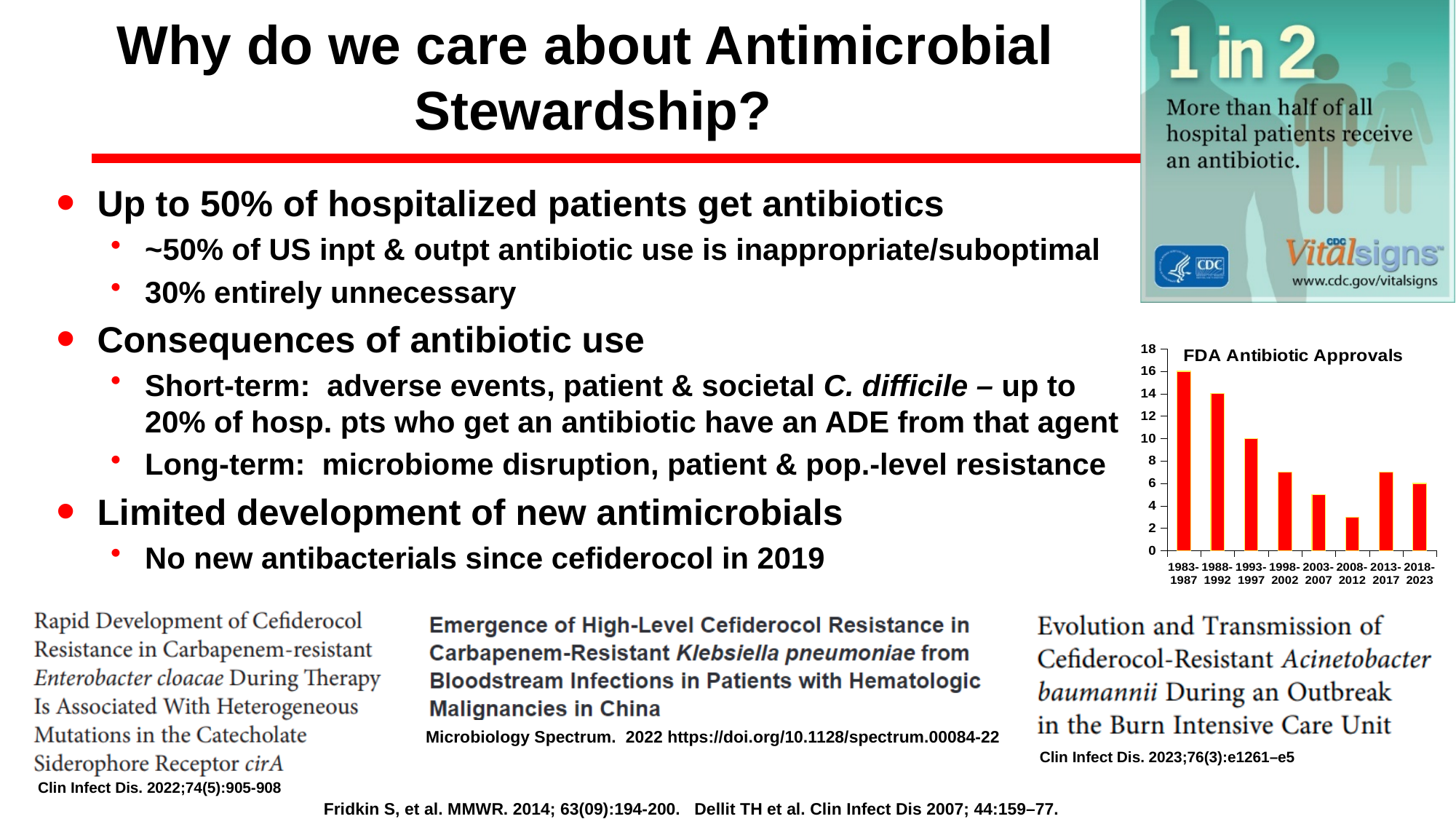
In the FDA Antibiotic Approvals chart, what is the difference between the values for 1983-1987 and 1988-1992? 2 In the FDA Antibiotic Approvals chart, is the value for 2008-2012 greater or less than 4? less In the FDA Antibiotic Approvals chart, do the values generally rise or fall from 1983-1987 to 2008-2012? fall In the FDA Antibiotic Approvals chart, what is the value for 1988-1992? 14 In the FDA Antibiotic Approvals chart, what is the value for 1983-1987? 16 In the FDA Antibiotic Approvals chart, what is the value for 1993-1997? 10 In the FDA Antibiotic Approvals chart, which period has more approvals, 1993-1997 or 2018-2023? 1993-1997 In the FDA Antibiotic Approvals chart, which period has the highest number of approvals? 1983-1987 How many time periods are shown on the x axis of the FDA Antibiotic Approvals chart? 8 In the FDA Antibiotic Approvals chart, which period has the lowest number of approvals? 2008-2012 What is the title of the chart on the right side of the slide? FDA Antibiotic Approvals What type of chart is the FDA Antibiotic Approvals chart? bar chart